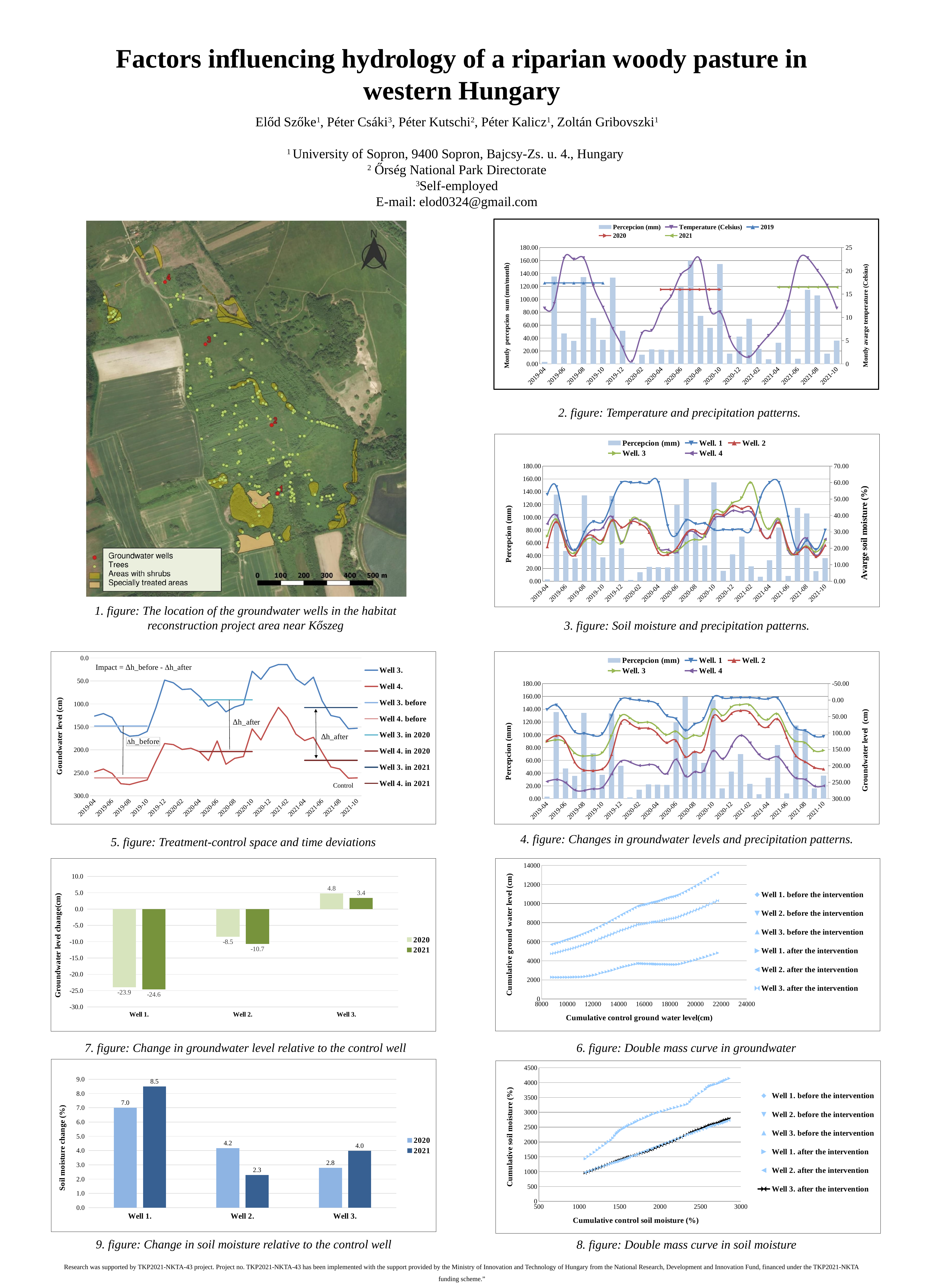
In the chart titled "9. figure: Change in soil moisture relative to the control well", what is the difference between the 2020 and 2021 values for Well 2.? 1.9 In the chart titled "7. figure: Change in groundwater level relative to the control well", how many series does the legend list? 2 In the chart titled "6. figure: Double mass curve in groundwater", how many series does the legend list? 6 In the chart titled "7. figure: Change in groundwater level relative to the control well", what is the 2021 value for Well 2.? -10.7 In the chart titled "7. figure: Change in groundwater level relative to the control well", what is the 2020 value for Well 1.? -23.9 In the chart titled "9. figure: Change in soil moisture relative to the control well", is the 2020 value for Well 2. larger or the 2021 value for Well 3.? 2020 value for Well 2. In the chart titled "9. figure: Change in soil moisture relative to the control well", which well has the lowest 2021 value? Well 2. In the chart titled "9. figure: Change in soil moisture relative to the control well", what is the 2021 value for Well 1.? 8.5 In the chart titled "7. figure: Change in groundwater level relative to the control well", which well has the highest 2021 value? Well 3. In the chart titled "7. figure: Change in groundwater level relative to the control well", what is the difference between the 2020 and 2021 values for Well 3.? 1.4 What kind of chart is "9. figure: Change in soil moisture relative to the control well"? Bar chart In the chart titled "9. figure: Change in soil moisture relative to the control well", how many wells are shown on the x axis? 3